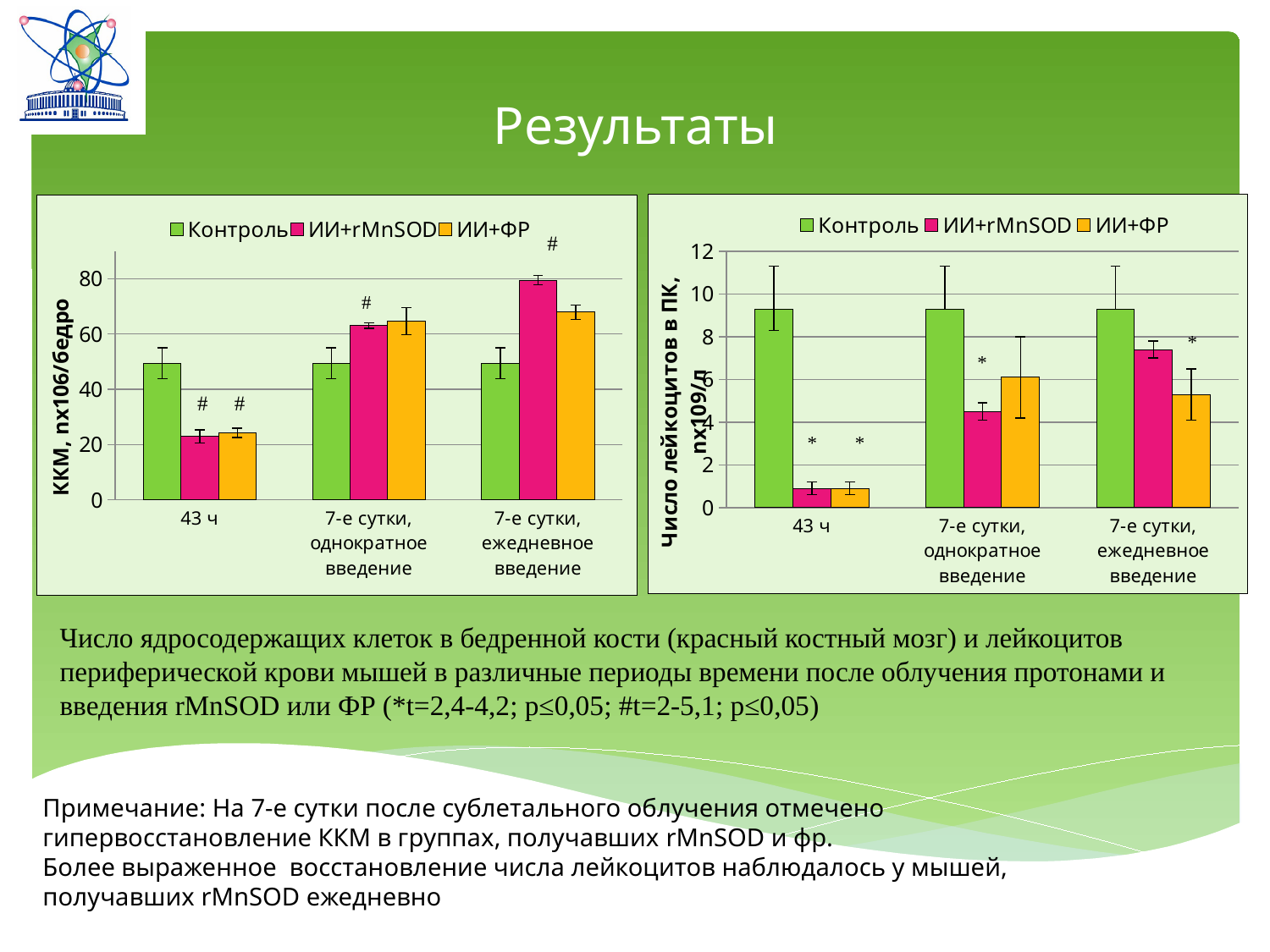
What kind of chart is the left chart (ККМ, nx106/бедро)? bar chart In the right chart (Число лейкоцитов в ПК), is the value for ИИ+rMnSOD at 43 ч greater or less than 2? less How many categories are shown on the x axis of the right chart (Число лейкоцитов в ПК)? 3 How many series does the legend of the left chart (ККМ, nx106/бедро) list? 3 In the left chart (ККМ, nx106/бедро), which series has the highest value at 7-е сутки, ежедневное введение? ИИ+rMnSOD What are the legend entries of the left chart (ККМ, nx106/бедро)? Контроль, ИИ+rMnSOD, ИИ+ФР In the right chart (Число лейкоцитов в ПК), is the value for Контроль at 43 ч greater or less than 8? greater In the left chart (ККМ, nx106/бедро), at 7-е сутки, ежедневное введение, which is larger: ИИ+rMnSOD or ИИ+ФР? ИИ+rMnSOD In the left chart (ККМ, nx106/бедро), is the value for ИИ+rMnSOD at 43 ч greater or less than 40? less In the right chart (Число лейкоцитов в ПК), at 7-е сутки, однократное введение, which is larger: ИИ+rMnSOD or ИИ+ФР? ИИ+ФР In the right chart (Число лейкоцитов в ПК), which series has the lowest value at 7-е сутки, ежедневное введение? ИИ+ФР